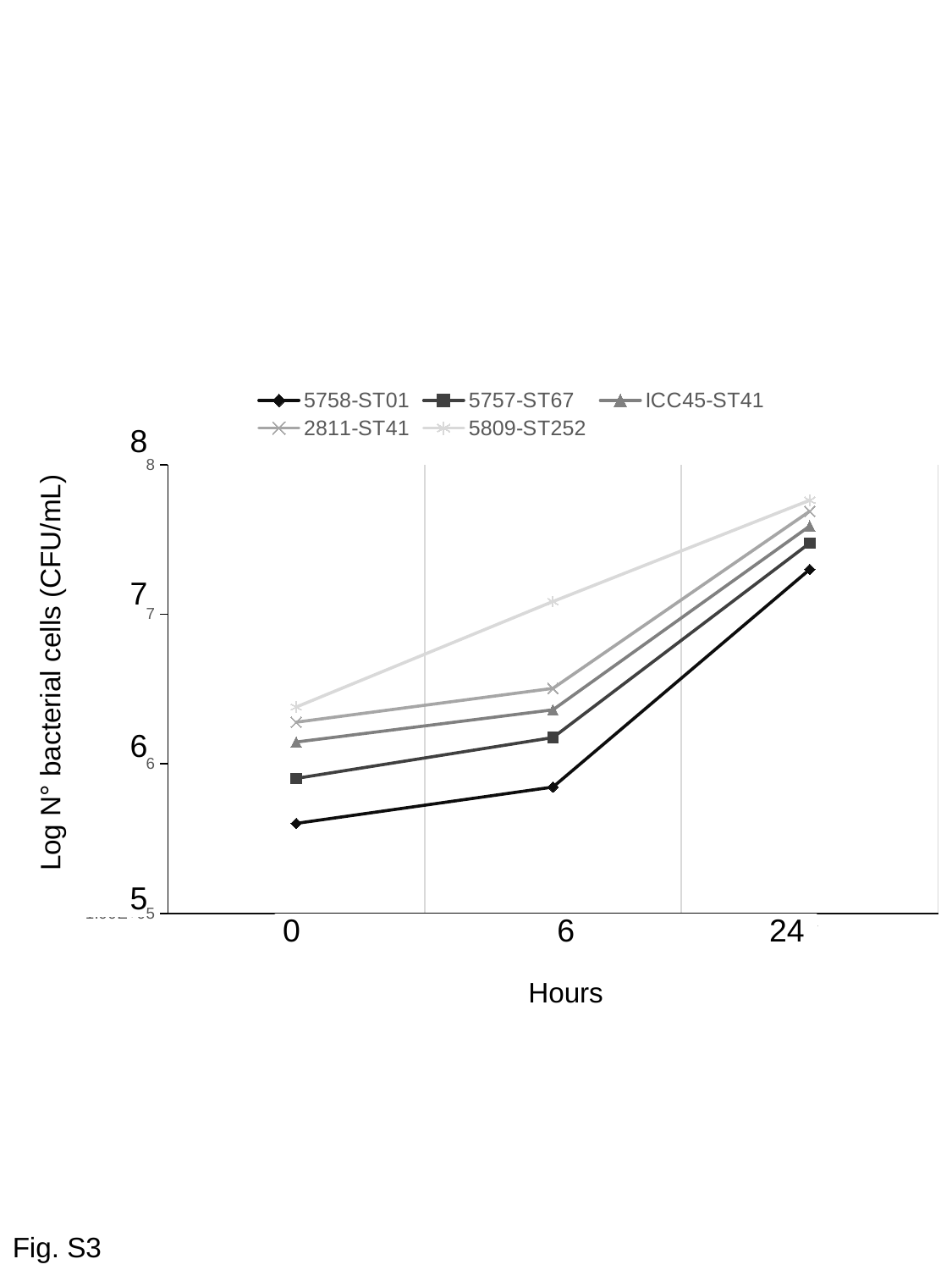
At 6 hours, which is larger: the value for 5809-ST252 or the value for 5758-ST01? 5809-ST252 Is the value for 5758-ST01 at 24 hours greater or less than 7? greater What kind of chart is shown on the slide? line chart Which series has the highest value at 6 hours? 5809-ST252 How many series does the legend list? 5 Which series has the lowest value at 24 hours? 5758-ST01 Which series has the lowest value at 6 hours? 5758-ST01 What is the title of the y axis? Log N° bacterial cells (CFU/mL) How many time points are plotted along the x axis? 3 Do the values for 5757-ST67 rise or fall from 0 to 24 hours? rise Is the value for 5809-ST252 at 0 hours greater or less than 6? greater Is the value for 5758-ST01 at 0 hours greater or less than 6? less